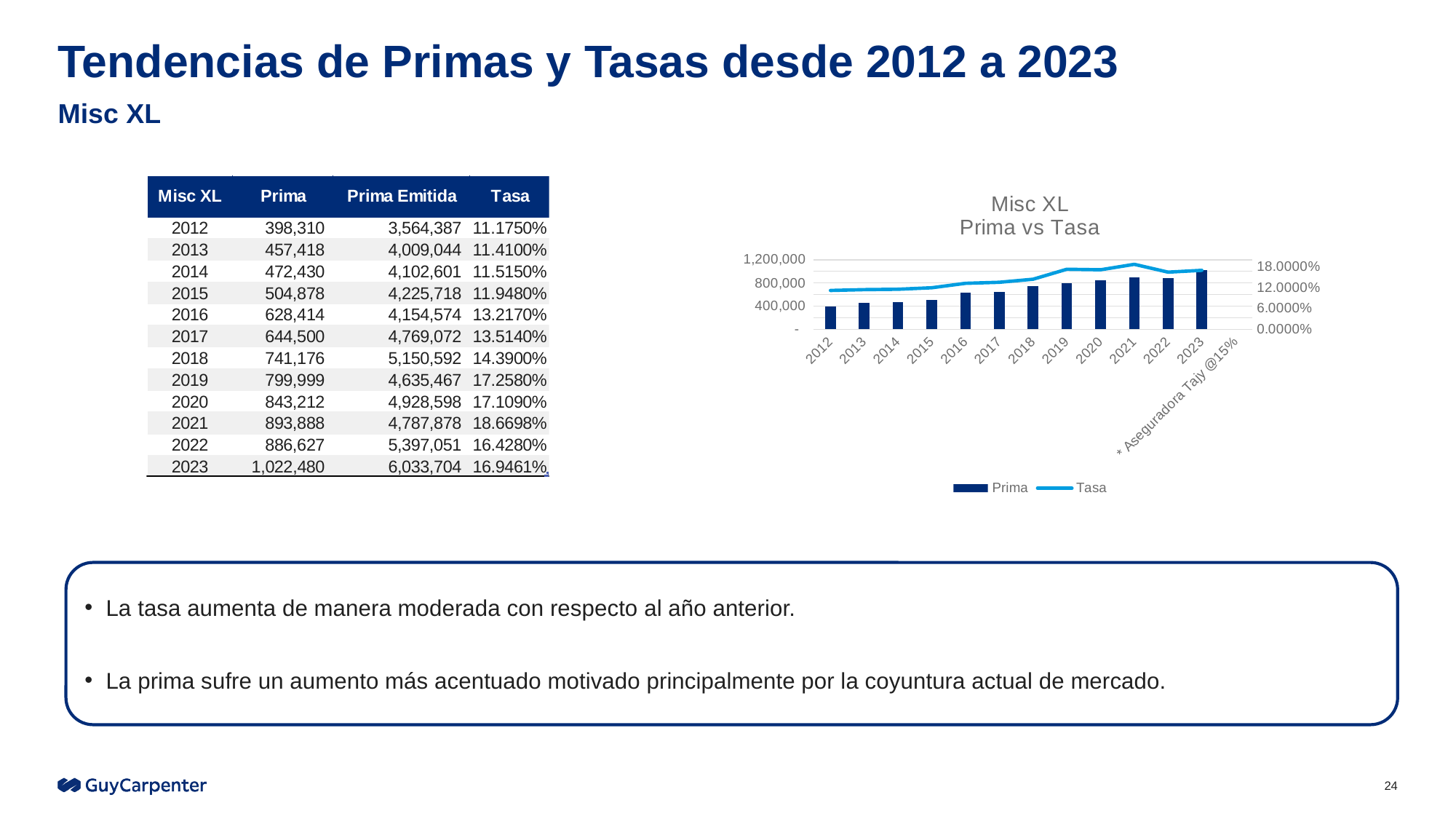
How many series does the chart legend list? 2 Which is larger, the Prima for 2019 or the Prima for 2016? 2019 How many years are plotted along the x axis of the chart? 12 Is the Prima value for 2016 greater or less than 400,000? greater Is the Prima value for 2023 greater or less than 800,000? greater Which year has the highest Prima bar in the chart? 2023 In which year does the Tasa line reach its peak? 2021 Which year has the lowest Prima bar in the chart? 2012 What is the Prima value for 2023 as shown in the table on the slide? 1,022,480 What kind of chart is shown on the slide? A bar chart with a line (combo chart) What is the title of the chart? Misc XL Prima vs Tasa Do the Prima bars generally rise or fall from 2012 to 2023? rise